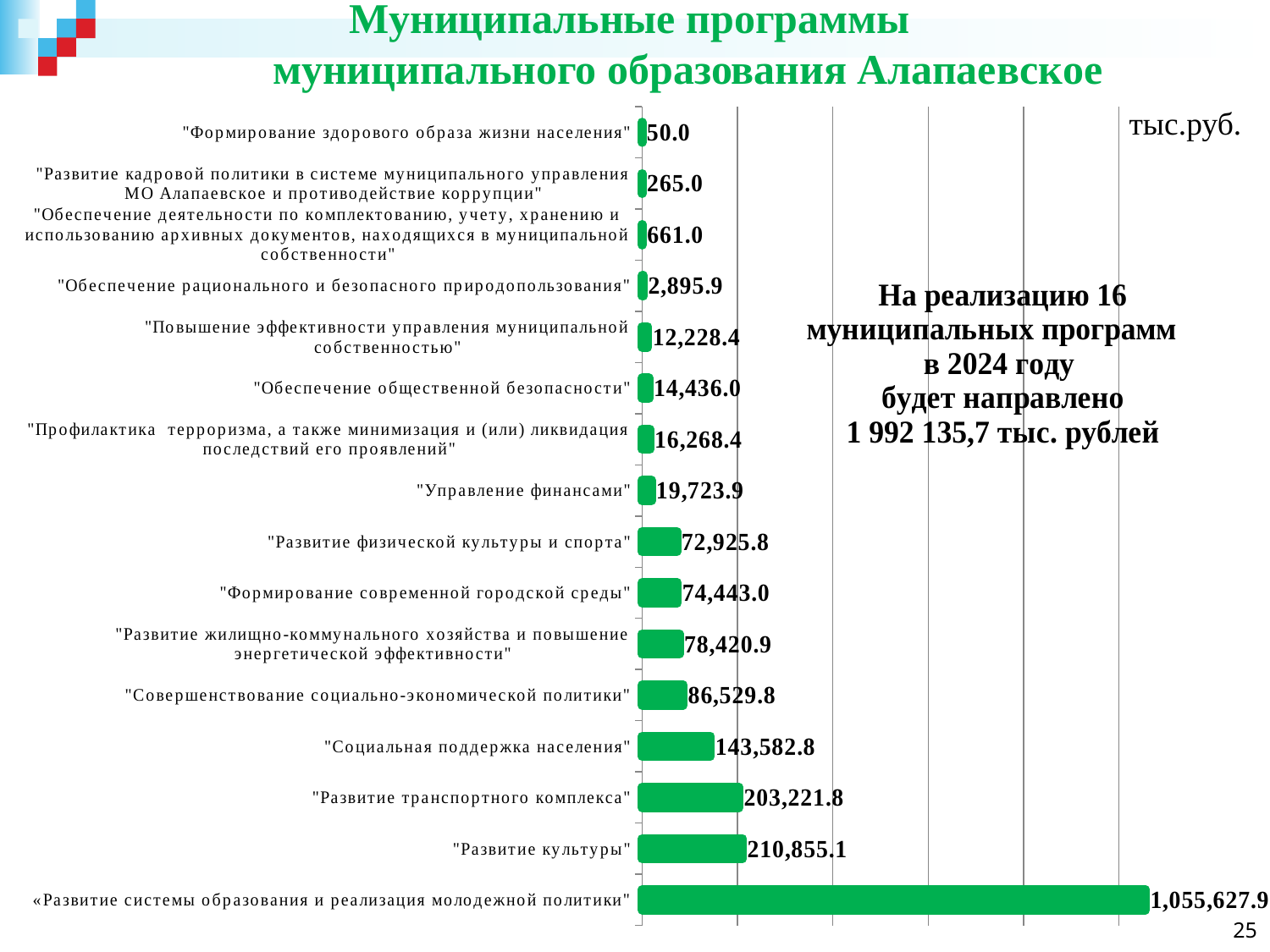
What kind of chart is shown on the slide? Bar chart What is the value for "Развитие культуры"? 210,855.1 Which is larger: the value for "Развитие физической культуры и спорта" or for "Формирование современной городской среды"? "Формирование современной городской среды" How many programs (categories) are shown in the chart? 16 What is the value for "Социальная поддержка населения"? 143,582.8 What is the value for "Управление финансами"? 19,723.9 What is the difference between the values for "Развитие культуры" and "Развитие транспортного комплекса"? 7,633.3 What is the difference between the values for "Социальная поддержка населения" and "Совершенствование социально-экономической политики"? 57,053.0 In what units are the values on the chart given? тыс.руб. What is the value for "Обеспечение общественной безопасности"? 14,436.0 Which program has the highest value? «Развитие системы образования и реализация молодежной политики" Which program has the lowest value? "Формирование здорового образа жизни населения"